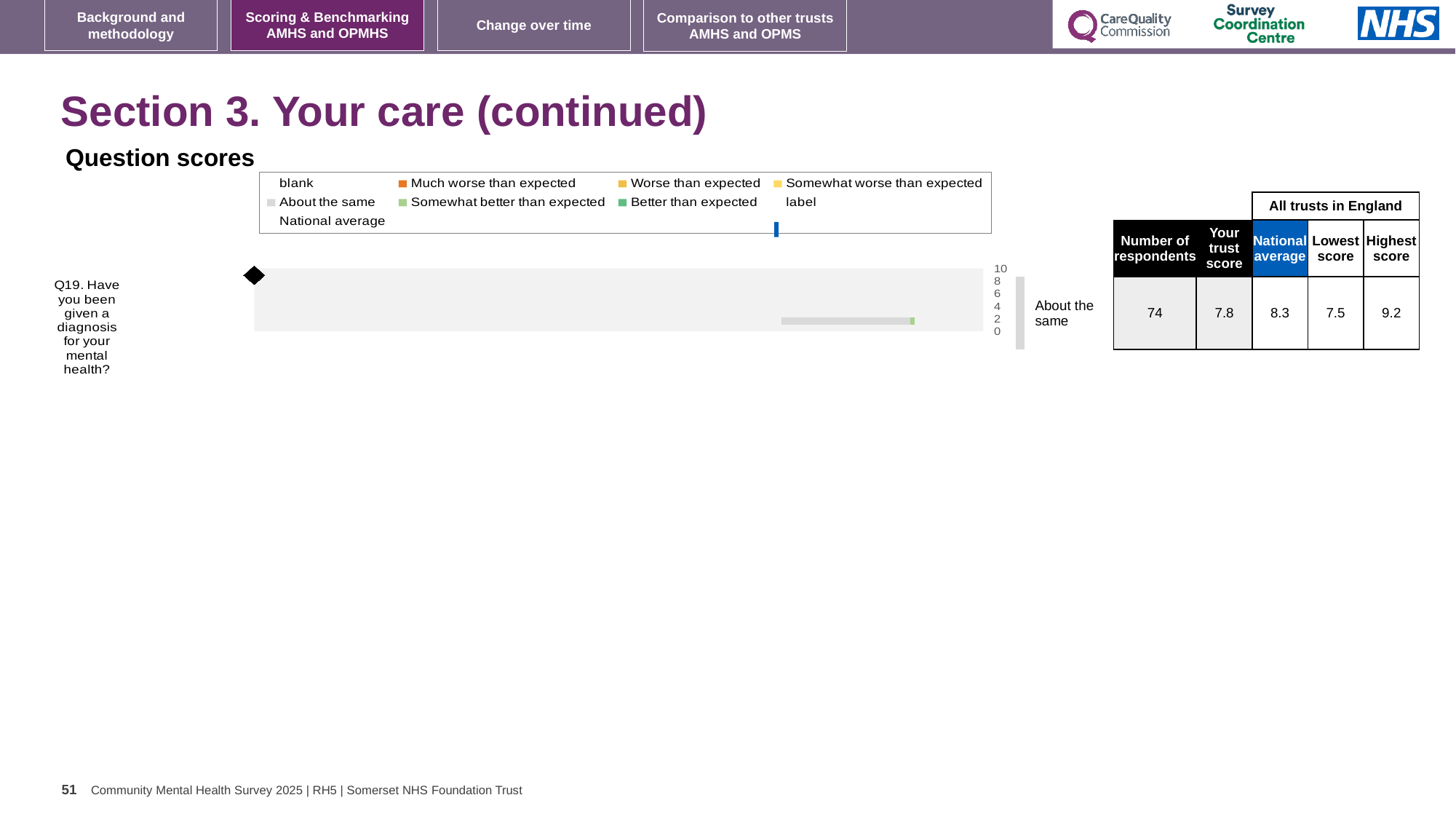
Which question is plotted in the 'Question scores' chart? Q19. Have you been given a diagnosis for your mental health? What is the difference between the highest and lowest scores among all trusts in England for Q19? 1.7 What comparison rating is shown next to the bar for Q19? About the same How many questions are plotted in the 'Question scores' chart? 1 What is the difference between the national average and the trust score for Q19? 0.5 How many respondents answered Q19? 74 Which is larger for Q19, the trust score or the national average? National average What is the trust score for Q19 shown on the slide? 7.8 What is the national average for Q19 shown on the slide? 8.3 What is the highest score among all trusts in England for Q19? 9.2 What is the lowest score among all trusts in England for Q19? 7.5 What kind of chart is shown under 'Question scores'? bar chart